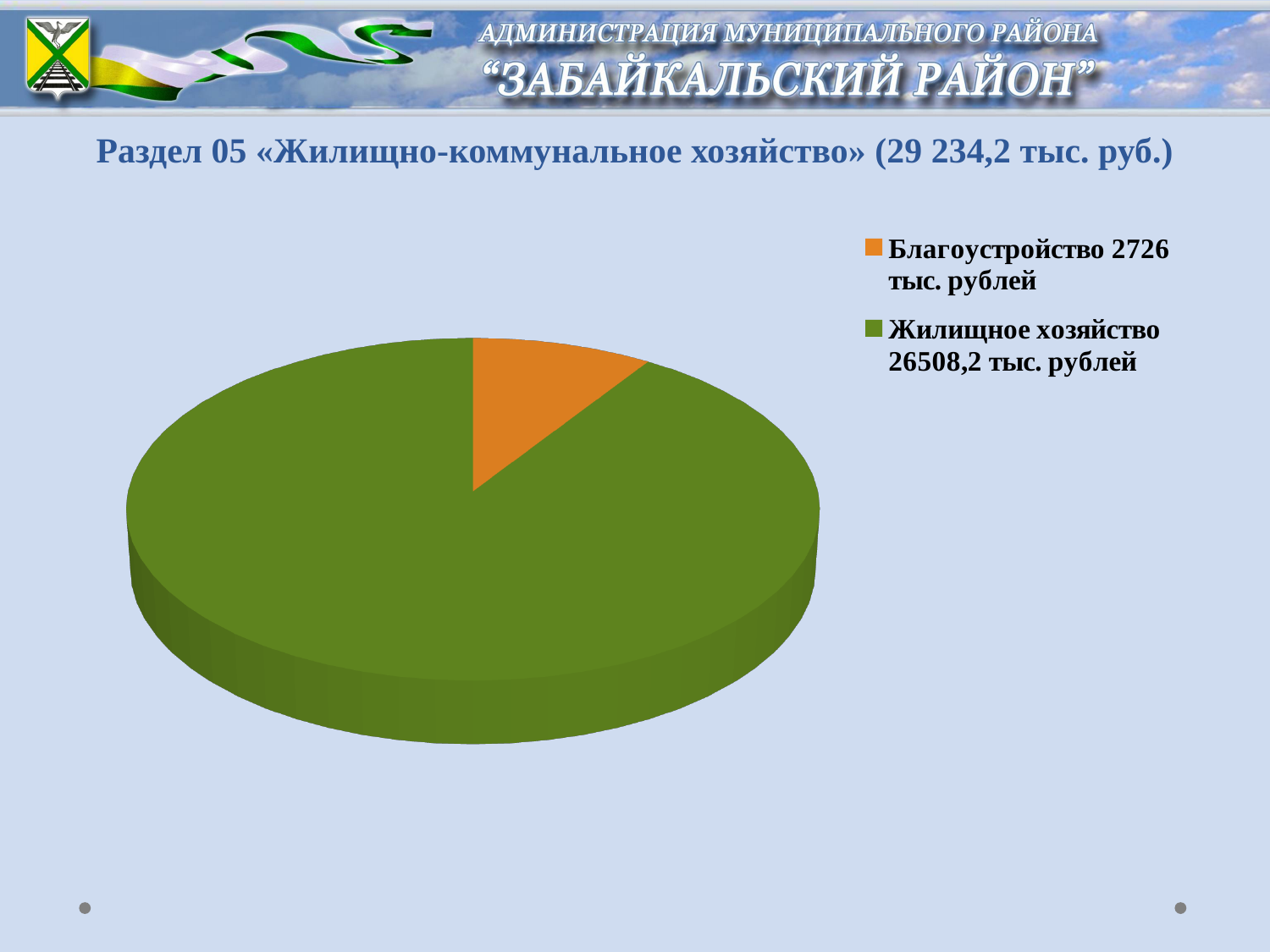
How many slices does the pie chart have? 2 What kind of chart is shown on the slide? pie chart Which category has the largest slice of the pie? Жилищное хозяйство What is the value for Благоустройство according to the legend? 2726 тыс. рублей How many entries does the legend list? 2 What total amount for Раздел 05 is given in the slide title? 29 234,2 тыс. руб. What is the title of the slide above the chart? Раздел 05 «Жилищно-коммунальное хозяйство» (29 234,2 тыс. руб.) Which is larger, Благоустройство or Жилищное хозяйство? Жилищное хозяйство What is the difference between Жилищное хозяйство and Благоустройство in тыс. рублей? 23782,2 What colour is the slice for Благоустройство? orange What is the value for Жилищное хозяйство according to the legend? 26508,2 тыс. рублей Which category has the smallest slice of the pie? Благоустройство